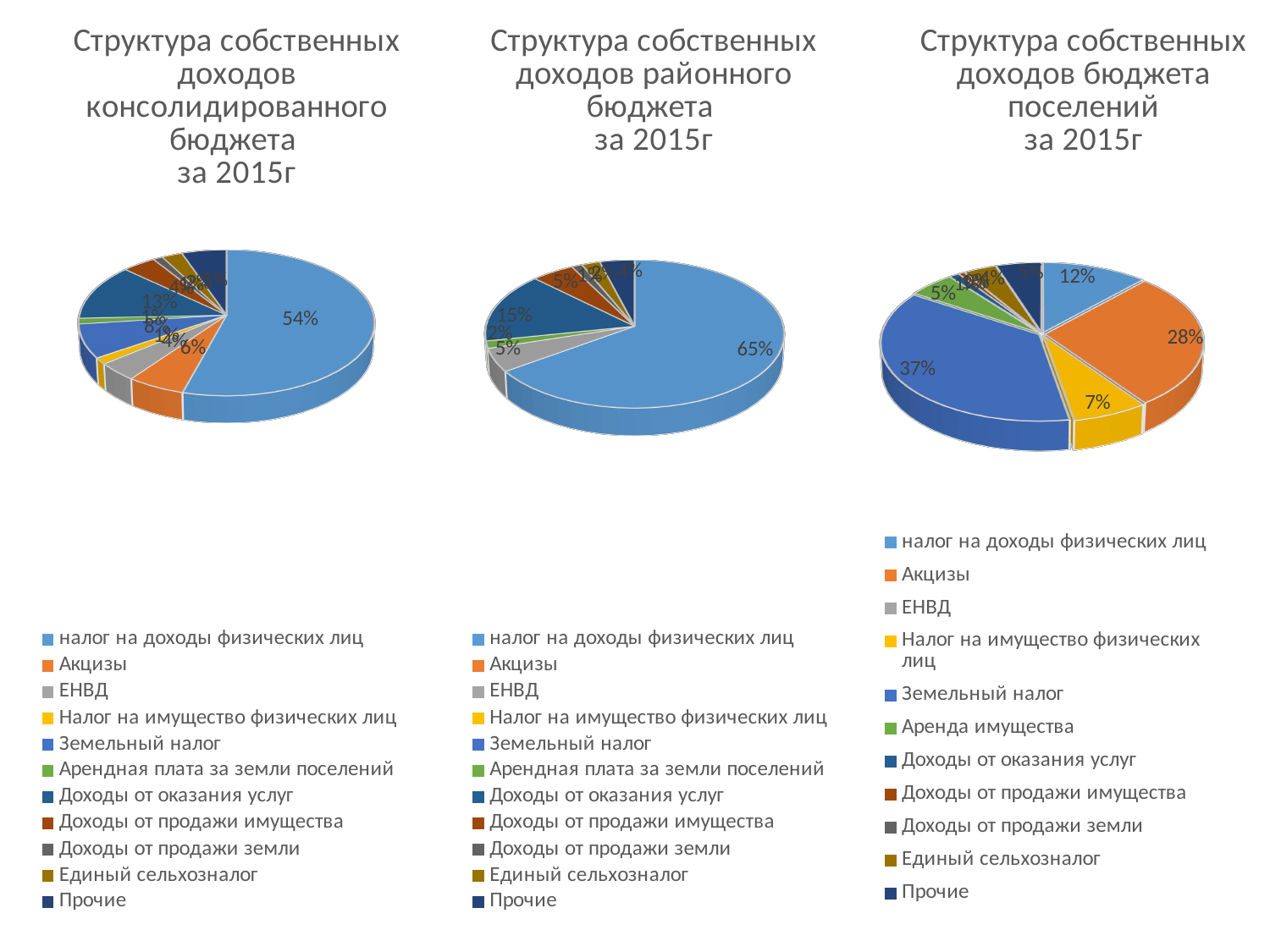
In the chart 'Структура собственных доходов районного бюджета за 2015г', what share does налог на доходы физических лиц have? 65% In the chart 'Структура собственных доходов бюджета поселений за 2015г', which category has the largest share? Земельный налог What kind of chart is used for 'Структура собственных доходов районного бюджета за 2015г'? Pie chart In the chart 'Структура собственных доходов консолидированного бюджета за 2015г', what share does налог на доходы физических лиц have? 54% How many entries does the legend of the chart 'Структура собственных доходов бюджета поселений за 2015г' list? 11 In the chart 'Структура собственных доходов бюджета поселений за 2015г', what share does Земельный налог have? 37% In the chart 'Структура собственных доходов бюджета поселений за 2015г', which is larger: Акцизы or налог на доходы физических лиц? Акцизы In the chart 'Структура собственных доходов консолидированного бюджета за 2015г', what share does Доходы от оказания услуг have? 13% In the chart 'Структура собственных доходов консолидированного бюджета за 2015г', how many percentage points larger is налог на доходы физических лиц than Доходы от оказания услуг? 41 percentage points In the chart 'Структура собственных доходов бюджета поселений за 2015г', how many percentage points larger is Земельный налог than Акцизы? 9 percentage points In the chart 'Структура собственных доходов районного бюджета за 2015г', what share does Доходы от оказания услуг have? 15% In the chart 'Структура собственных доходов бюджета поселений за 2015г', what share does Акцизы have? 28%